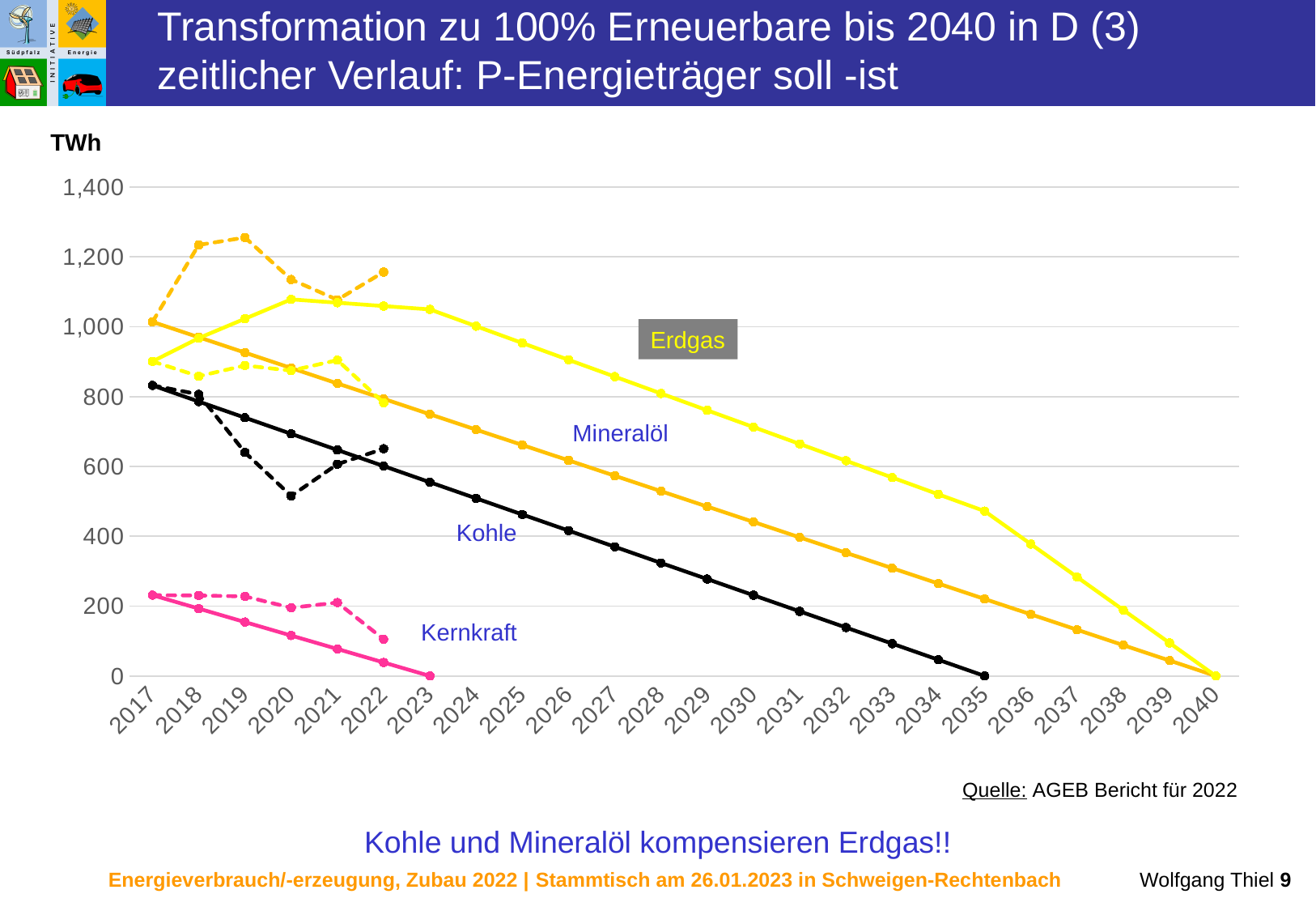
What unit is shown for the y axis of the chart? TWh In 2030, which solid line is higher: Erdgas or Mineralöl? Erdgas How many years are shown along the x axis of the chart? 24 In which year does the solid Kernkraft line reach 0 TWh? 2023 Is the solid Erdgas value for 2020 greater or less than 1,000 TWh? greater Is the solid Kohle value for 2030 greater or less than 400 TWh? less What kind of chart is shown on the slide? line chart In which year does the solid Kohle line reach 0 TWh? 2035 Does the solid Kohle line rise or fall from 2017 to 2035? fall Which energy source has the highest solid-line value in 2020? Erdgas Which energy source has the lowest value in 2017? Kernkraft In which year do the solid Erdgas and Mineralöl lines reach 0 TWh? 2040